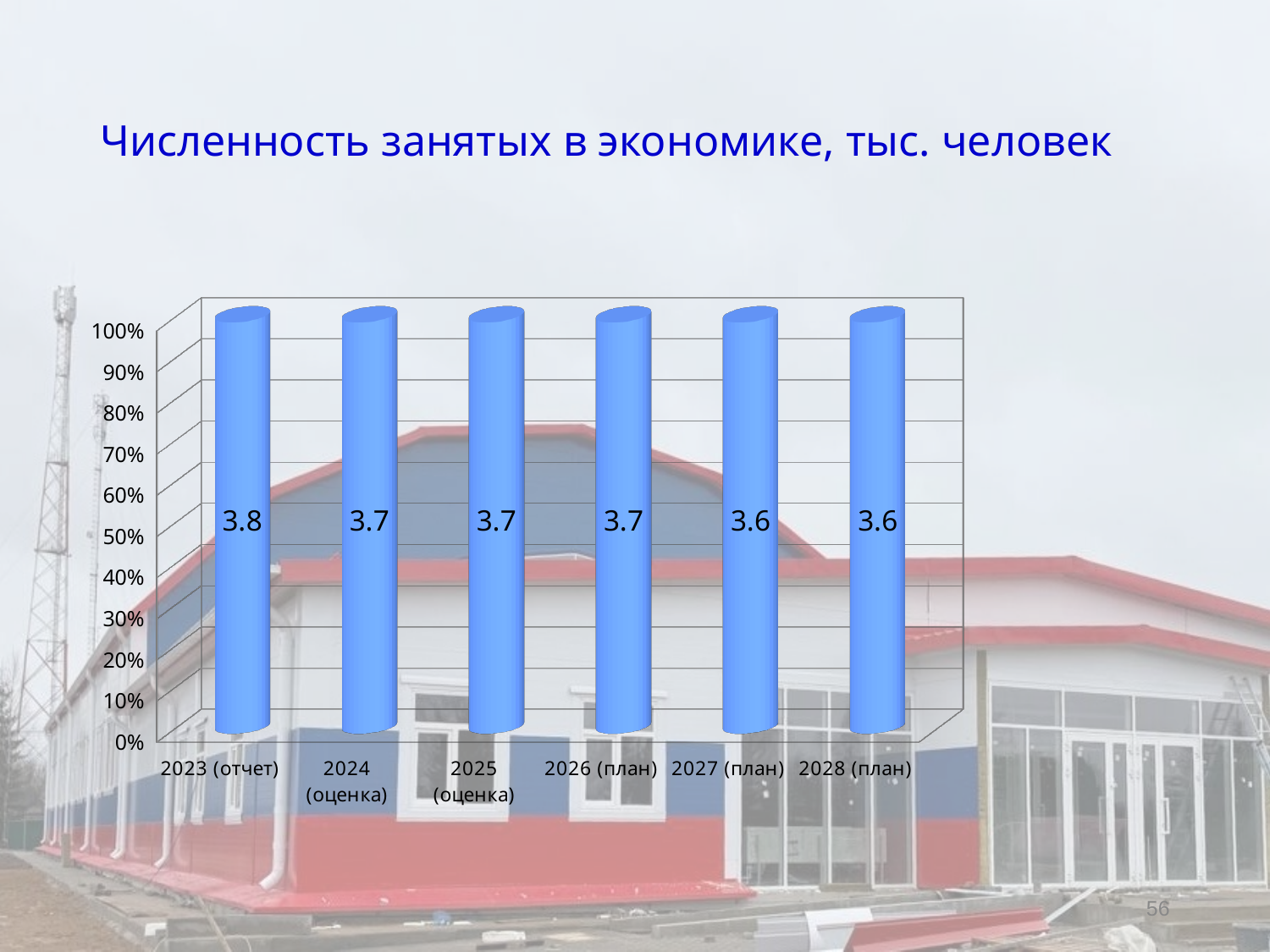
Do the labelled values rise or fall from 2023 to 2028? Fall How many years are shown on the x axis? 6 What is the title of the chart? Численность занятых в экономике, тыс. человек What is the difference between the values for 2023 (отчет) and 2028 (план)? 0.2 What is the value shown for 2024 (оценка)? 3.7 Which year has the highest value? 2023 (отчет) What kind of chart is shown on the slide? Bar chart What is the value shown for 2026 (план)? 3.7 What is the value shown for 2023 (отчет)? 3.8 Which is larger, the value for 2023 (отчет) or the value for 2027 (план)? 2023 (отчет) What is the difference between the values for 2024 (оценка) and 2027 (план)? 0.1 What is the value shown for 2028 (план)? 3.6